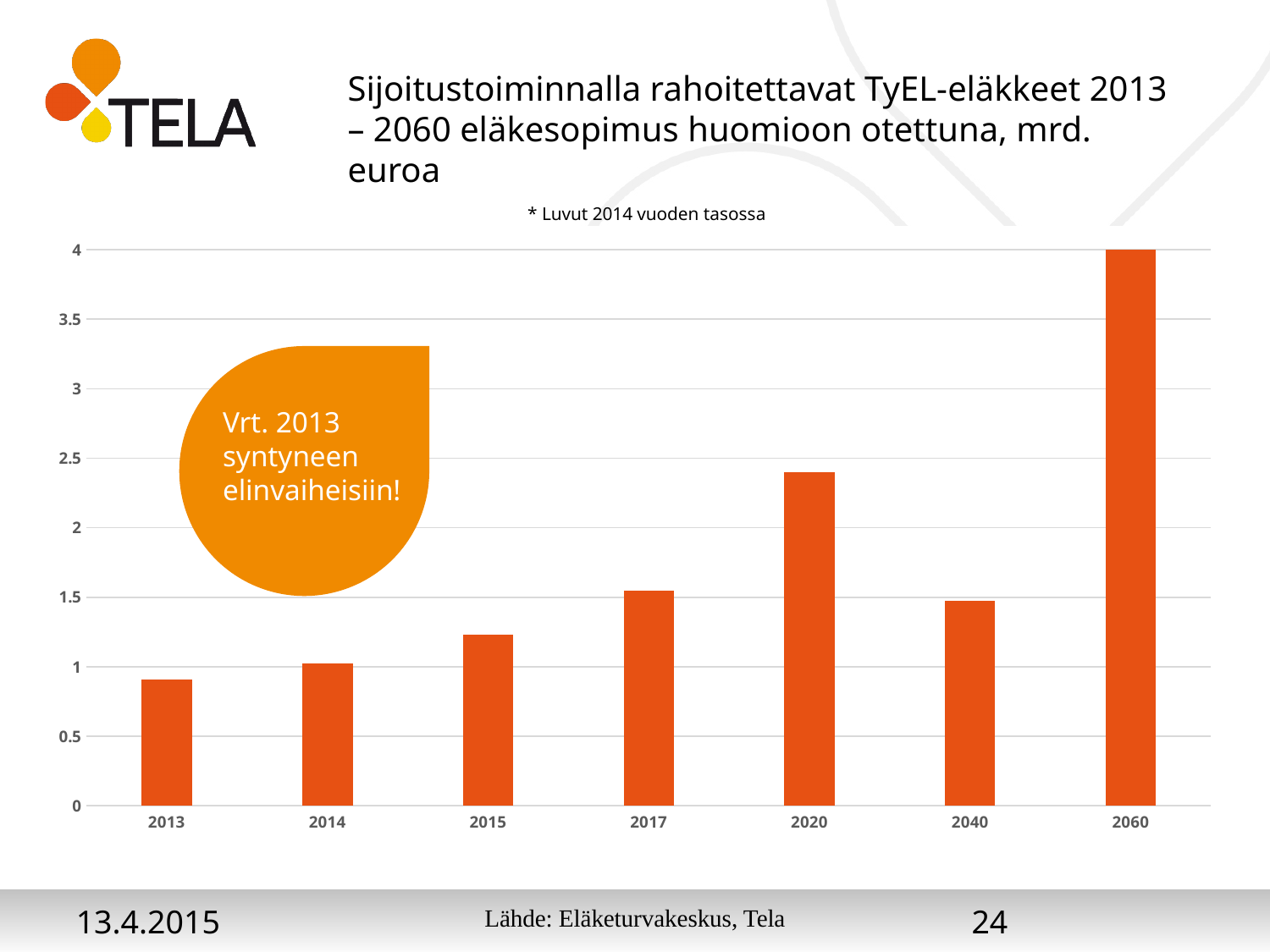
Which year has the lowest value in the chart? 2013 Is the value for 2060 greater or less than 3? greater How many years are shown on the x axis of the chart? 7 What text is written in the orange callout bubble on the chart? Vrt. 2013 syntyneen elinvaiheisiin! Is the value for 2015 greater or less than 1.5? less What kind of chart is shown on the slide? bar chart Is the value for 2017 greater or less than 2? less Do the values rise or fall from 2013 to 2020? rise Which is larger, the value for 2020 or the value for 2040? 2020 Which year has the highest value in the chart? 2060